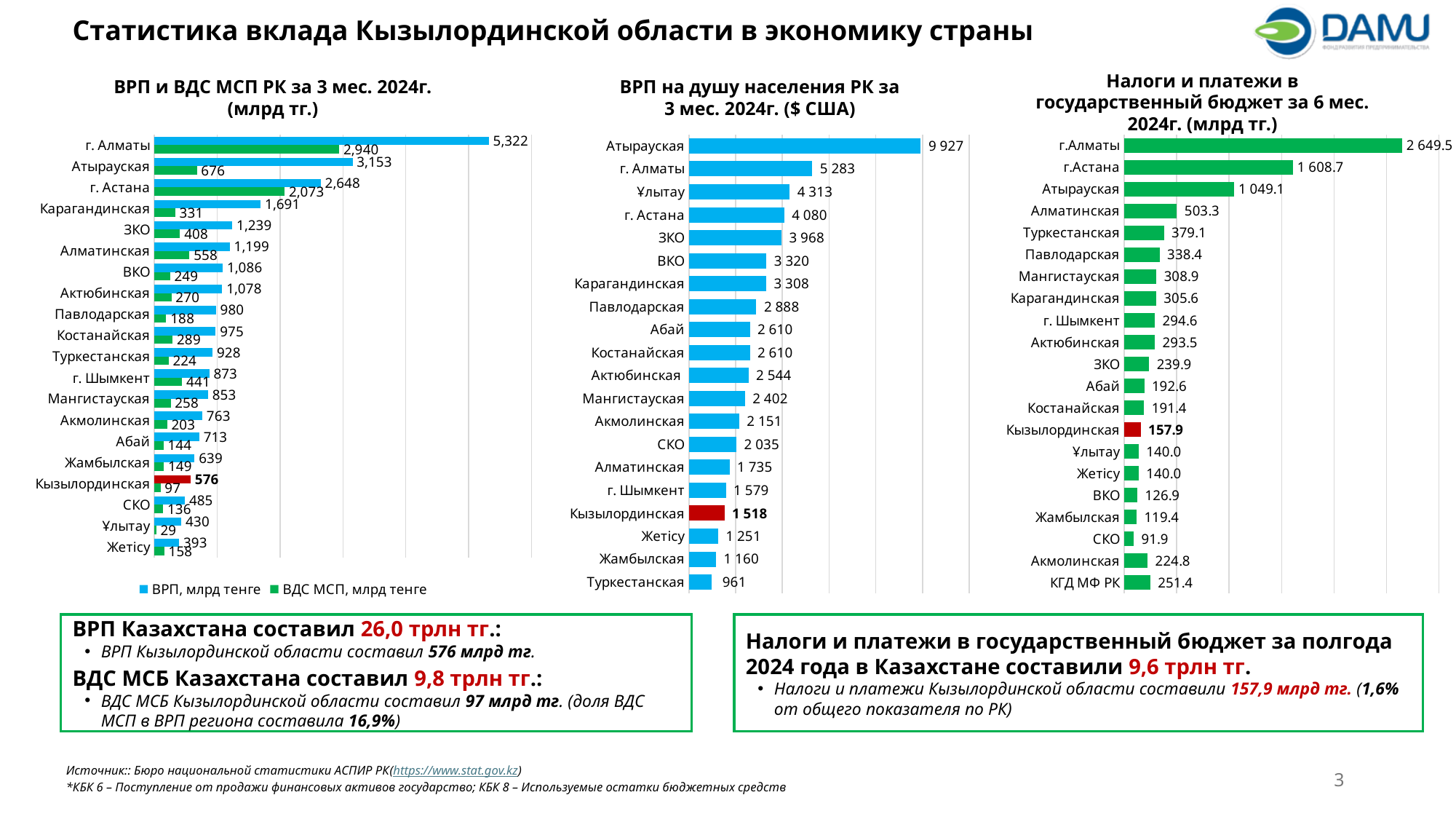
In the chart 'Налоги и платежи в государственный бюджет за 6 мес. 2024г. (млрд тг.)', what is the difference between the values for г.Алматы and г.Астана? 1 040.8 In the chart 'ВРП на душу населения РК за 3 мес. 2024г. ($ США)', what is the value for Кызылординская? 1 518 In the chart 'ВРП и ВДС МСП РК за 3 мес. 2024г. (млрд тг.)', what is the ВРП value for Кызылординская? 576 In the chart 'ВРП на душу населения РК за 3 мес. 2024г. ($ США)', how many regions are shown? 20 In the chart 'ВРП и ВДС МСП РК за 3 мес. 2024г. (млрд тг.)', what is the ВДС МСП value for Атырауская? 676 In the chart 'ВРП и ВДС МСП РК за 3 мес. 2024г. (млрд тг.)', what is the difference between the ВРП and ВДС МСП values for г. Алматы? 2,382 In the chart 'Налоги и платежи в государственный бюджет за 6 мес. 2024г. (млрд тг.)', which is larger: the value for Туркестанская or for Павлодарская? Туркестанская In the chart 'ВРП и ВДС МСП РК за 3 мес. 2024г. (млрд тг.)', how many series does the legend list? 2 In the chart 'ВРП на душу населения РК за 3 мес. 2024г. ($ США)', which region has the lowest value? Туркестанская In the chart 'ВРП на душу населения РК за 3 мес. 2024г. ($ США)', which region has the highest value? Атырауская In the chart 'ВРП и ВДС МСП РК за 3 мес. 2024г. (млрд тг.)', which region has the highest ВРП value? г. Алматы In the chart 'Налоги и платежи в государственный бюджет за 6 мес. 2024г. (млрд тг.)', what is the value for Кызылординская? 157.9